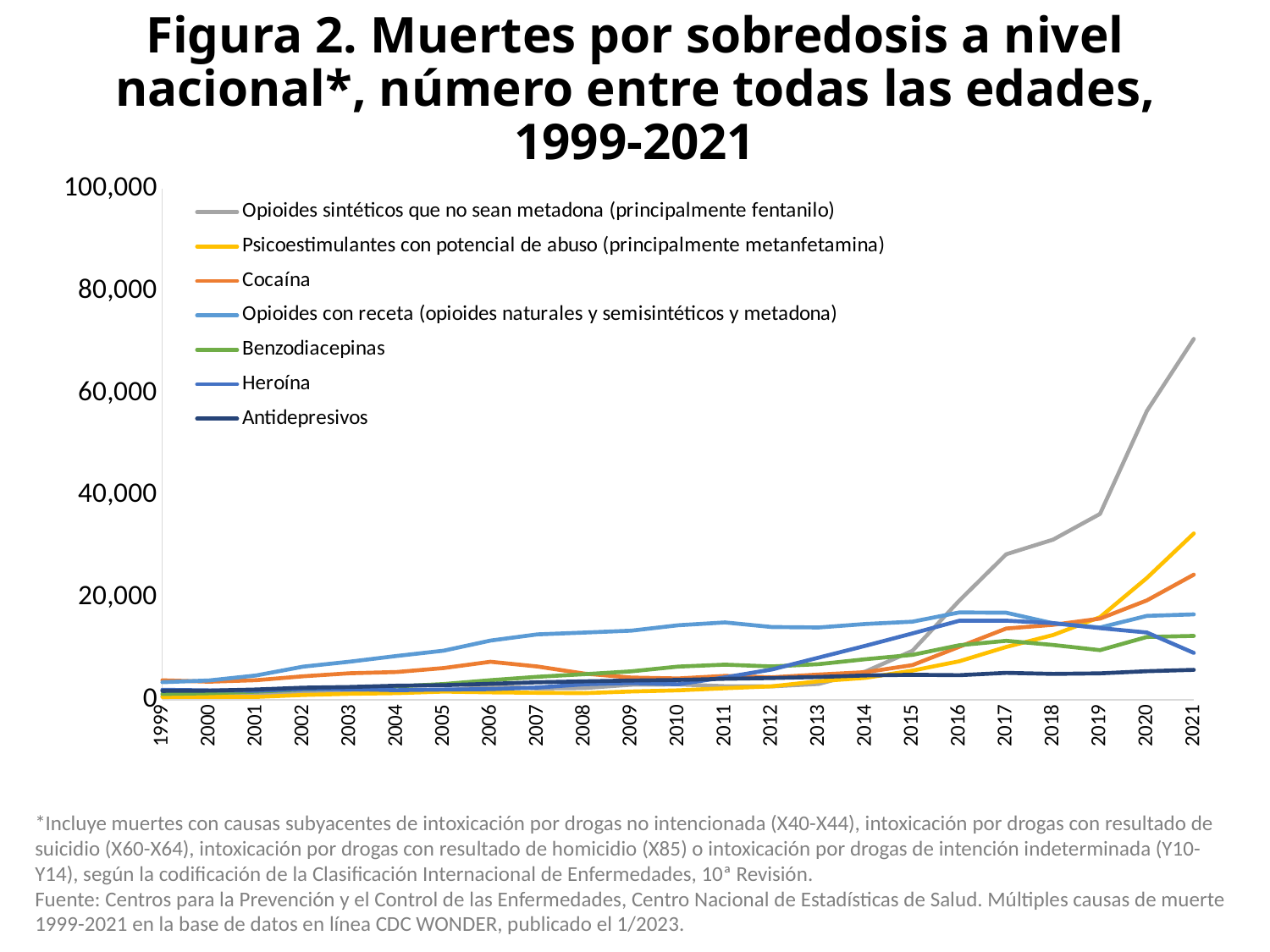
Is the value for Heroína in 2021 greater or less than 20,000? less What kind of chart is shown on the slide? line chart How many years are plotted along the x axis? 23 Does the Opioides sintéticos que no sean metadona series rise or fall from 2015 to 2021? rise How many series does the legend list? 7 Which series has the highest value in 2010? Opioides con receta (opioides naturales y semisintéticos y metadona) Which series has the lowest value in 2021? Antidepresivos In 2021, which is larger: the value for Cocaína or the value for Opioides sintéticos que no sean metadona? Opioides sintéticos que no sean metadona Is the value for Psicoestimulantes con potencial de abuso in 2021 greater or less than 20,000? greater Which series has the highest value in 2021? Opioides sintéticos que no sean metadona (principalmente fentanilo) Is the value for Opioides sintéticos que no sean metadona in 2021 greater or less than 60,000? greater What colour is the line for Cocaína? orange